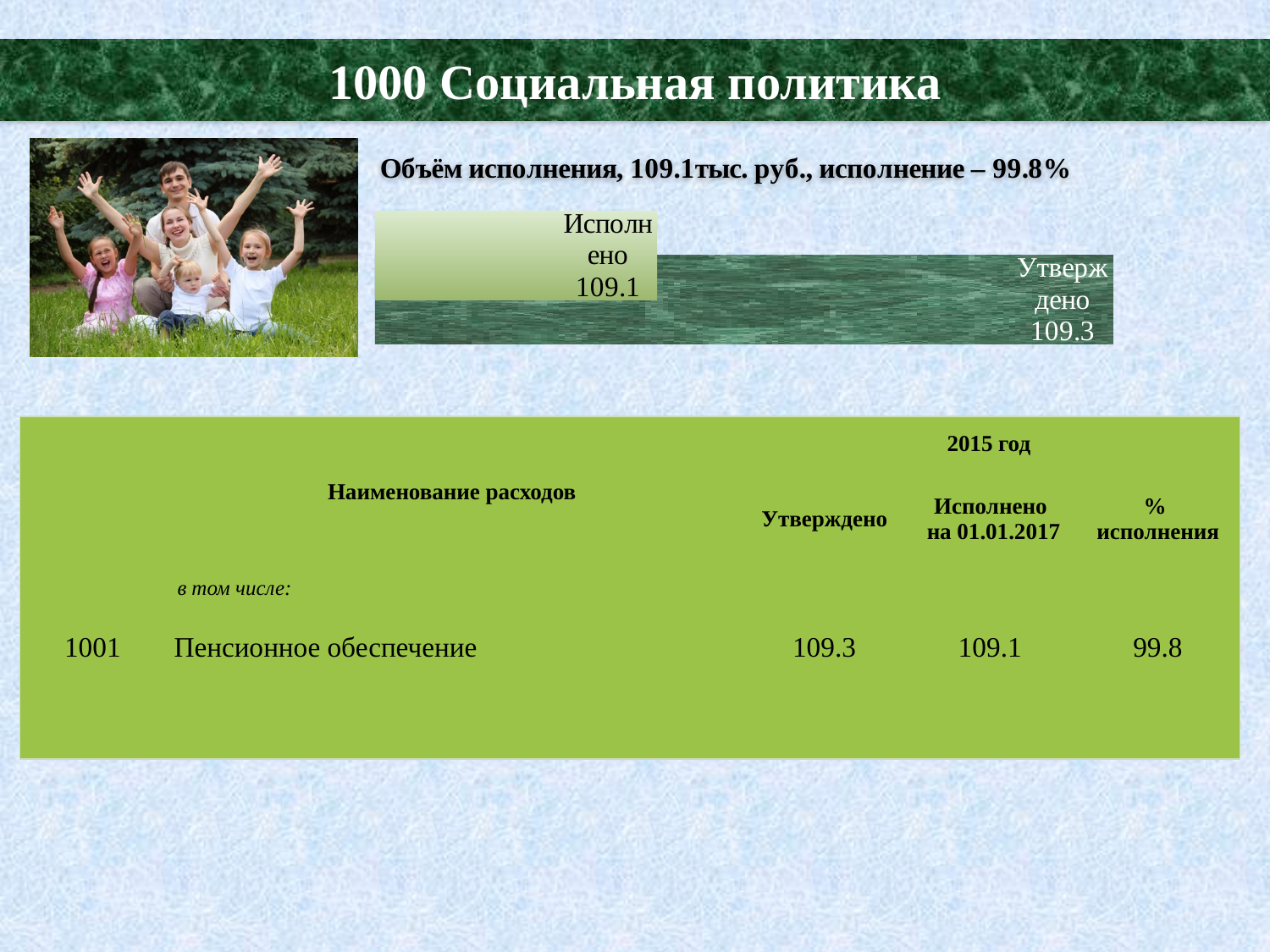
What kind of chart is shown on the slide? bar chart Is the value for Исполнено greater or less than 100? greater Which bar in the chart is drawn in a light green fill? Исполнено What is the difference between the Утверждено and Исполнено values in the chart? 0.2 According to the data labels, which bar has the larger value, Утверждено or Исполнено? Утверждено How many bars are plotted in the chart? 2 What is the value of the Исполнено bar in the chart? 109.1 What is the value of the Утверждено bar in the chart? 109.3 Which bar in the chart is drawn in a dark green textured fill? Утверждено According to the data labels, which bar has the smallest value in the chart? Исполнено